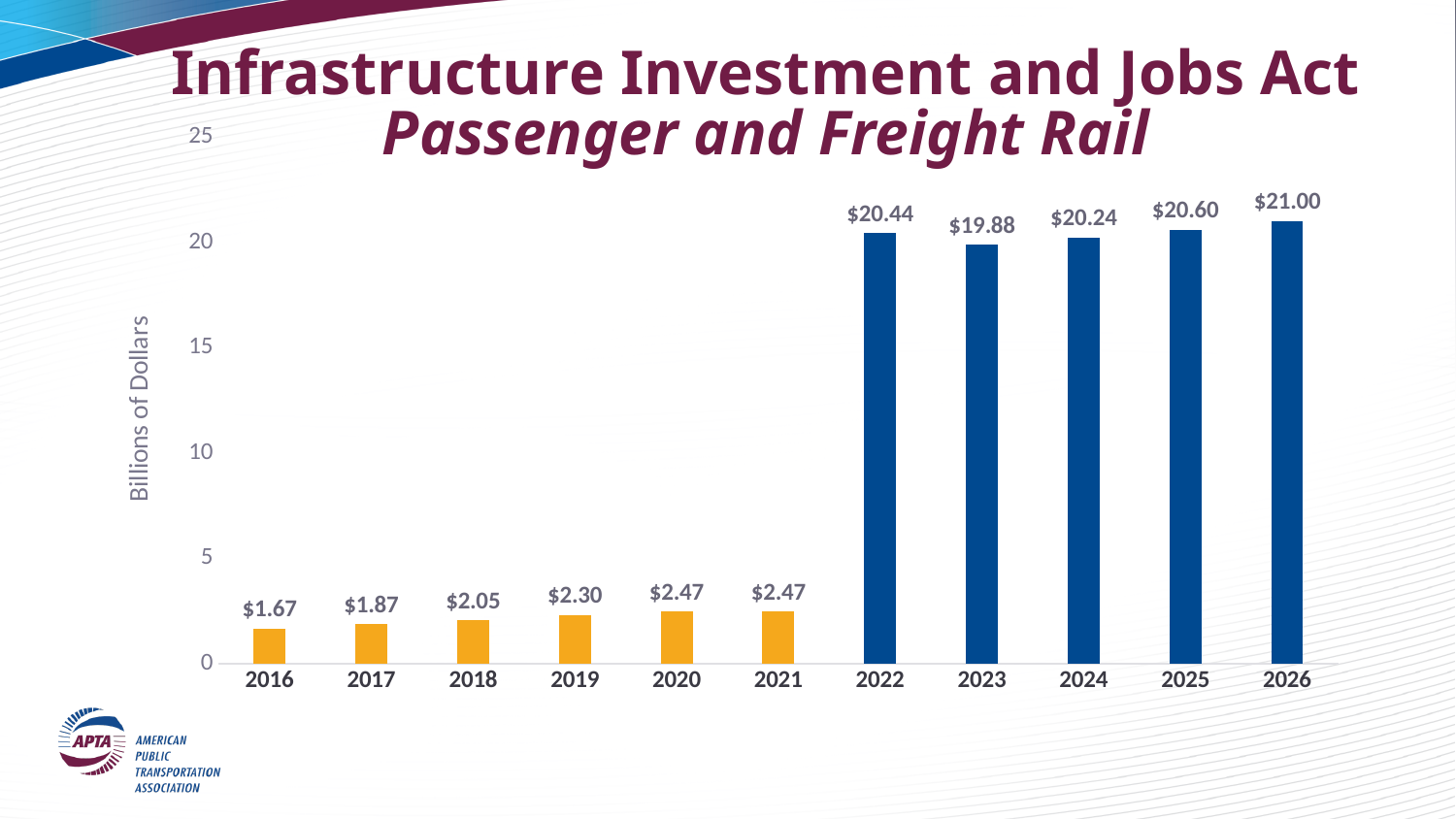
What is the value for 2019? $2.30 What is the value for 2016? $1.67 What is the difference between the values for 2026 and 2023? $1.12 What kind of chart is shown on the slide? bar chart What is the difference between the values for 2022 and 2021? $17.97 Which year has the highest value? 2026 What is the value for 2022? $20.44 Which year has the lowest value? 2016 Which is larger, the value for 2023 or the value for 2025? 2025 How many years are shown on the x axis? 11 Is the value for 2024 greater or less than 20? greater What is the label of the vertical axis? Billions of Dollars